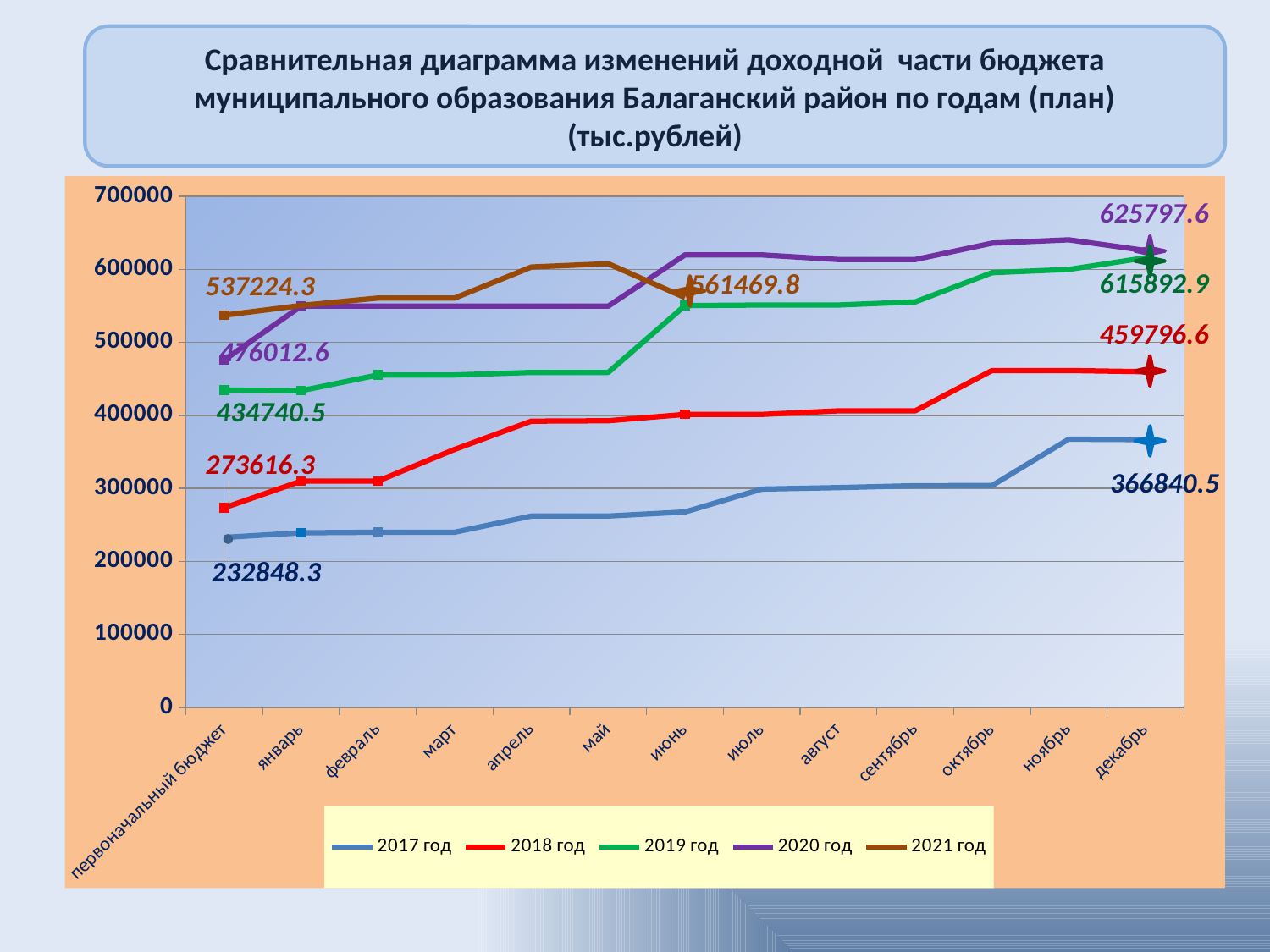
What kind of chart is shown on the slide? line chart What is the value for 2021 год in июнь? 561469.8 What is the value for 2017 год at первоначальный бюджет? 232848.3 How many categories are shown along the x axis? 13 What is the value for 2020 год in декабрь? 625797.6 Is the value for 2017 год in март greater or less than 300000? less What is the difference between the 2018 год value in декабрь and its value at первоначальный бюджет? 186180.3 Does the 2018 год line generally rise or fall from первоначальный бюджет to декабрь? rise What is the value for 2019 год at первоначальный бюджет? 434740.5 How many series does the legend list? 5 Which series has the higher value in декабрь, 2019 год or 2020 год? 2020 год Which series has the highest value at первоначальный бюджет? 2021 год